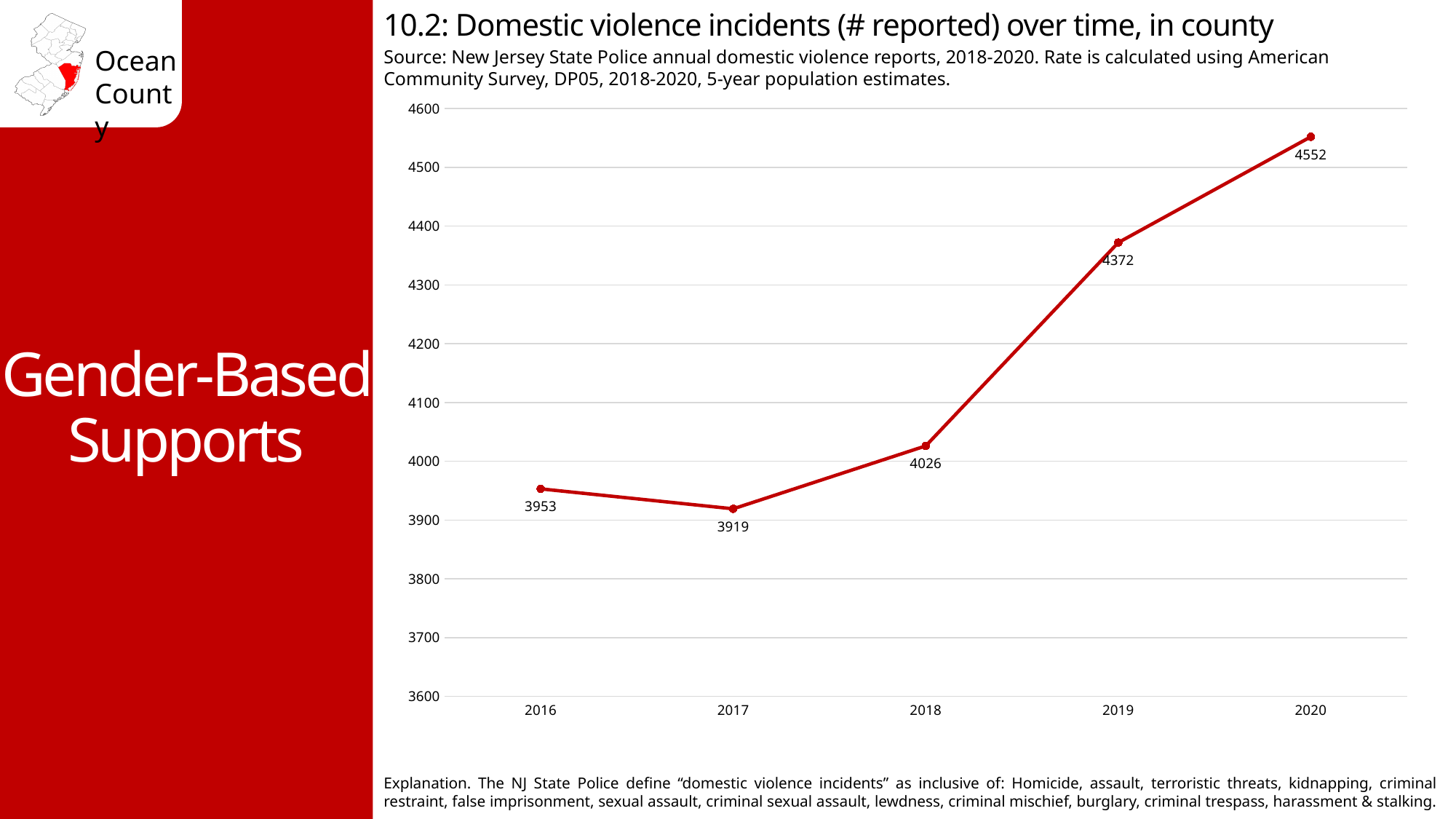
By how much did reported incidents increase from 2016 to 2020? 599 Is the value for 2019 greater or less than 4300? greater Which year had the highest number of reported domestic violence incidents? 2020 What is the difference in reported incidents between 2020 and 2019? 180 Which year had the lowest number of reported domestic violence incidents? 2017 What was the number of reported domestic violence incidents in 2020? 4552 How many domestic violence incidents were reported in 2018? 4026 What is the overall trend in reported domestic violence incidents from 2017 to 2020? Rising Were more incidents reported in 2019 or in 2018? 2019 How many years are plotted on the chart? 5 How many incidents were reported in 2016? 3953 What type of chart is shown on the slide? Line chart